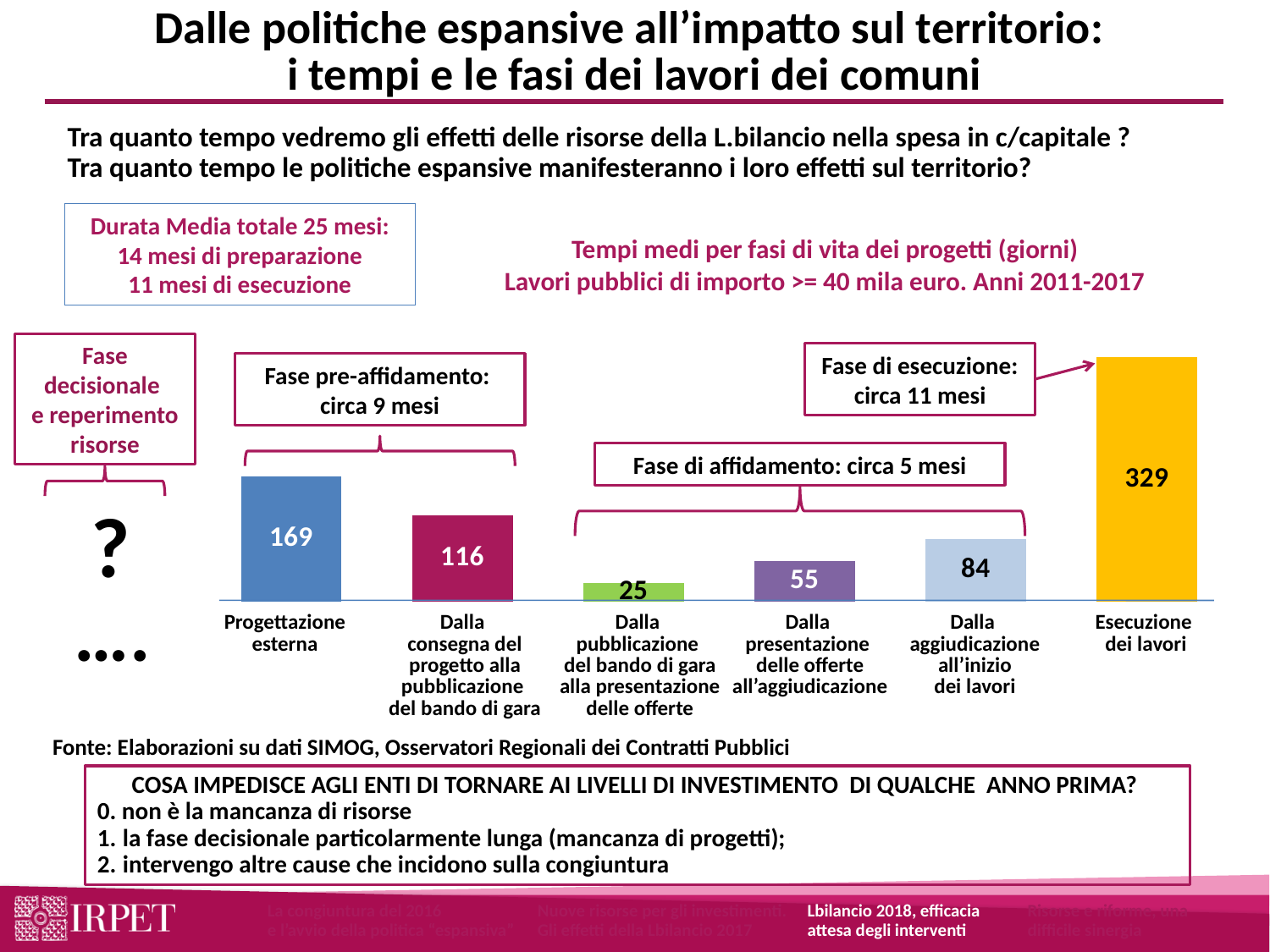
What kind of chart is shown on the slide? Bar chart What is the difference between the values for "Esecuzione dei lavori" and "Progettazione esterna"? 160 How many bars with values are plotted in the chart? 6 What is the value for "Progettazione esterna"? 169 What is the value for the phase "Dalla aggiudicazione all'inizio dei lavori"? 84 What is the value for the phase "Dalla pubblicazione del bando di gara alla presentazione delle offerte"? 25 Which phase has the lowest value? Dalla pubblicazione del bando di gara alla presentazione delle offerte Which is larger: the value for "Dalla presentazione delle offerte all'aggiudicazione" or for "Dalla aggiudicazione all'inizio dei lavori"? Dalla aggiudicazione all'inizio dei lavori Which phase has the highest value? Esecuzione dei lavori What is the difference between the values for "Progettazione esterna" and "Dalla consegna del progetto alla pubblicazione del bando di gara"? 53 What is the value for "Esecuzione dei lavori"? 329 In what unit are the values in the chart expressed, according to its title? giorni